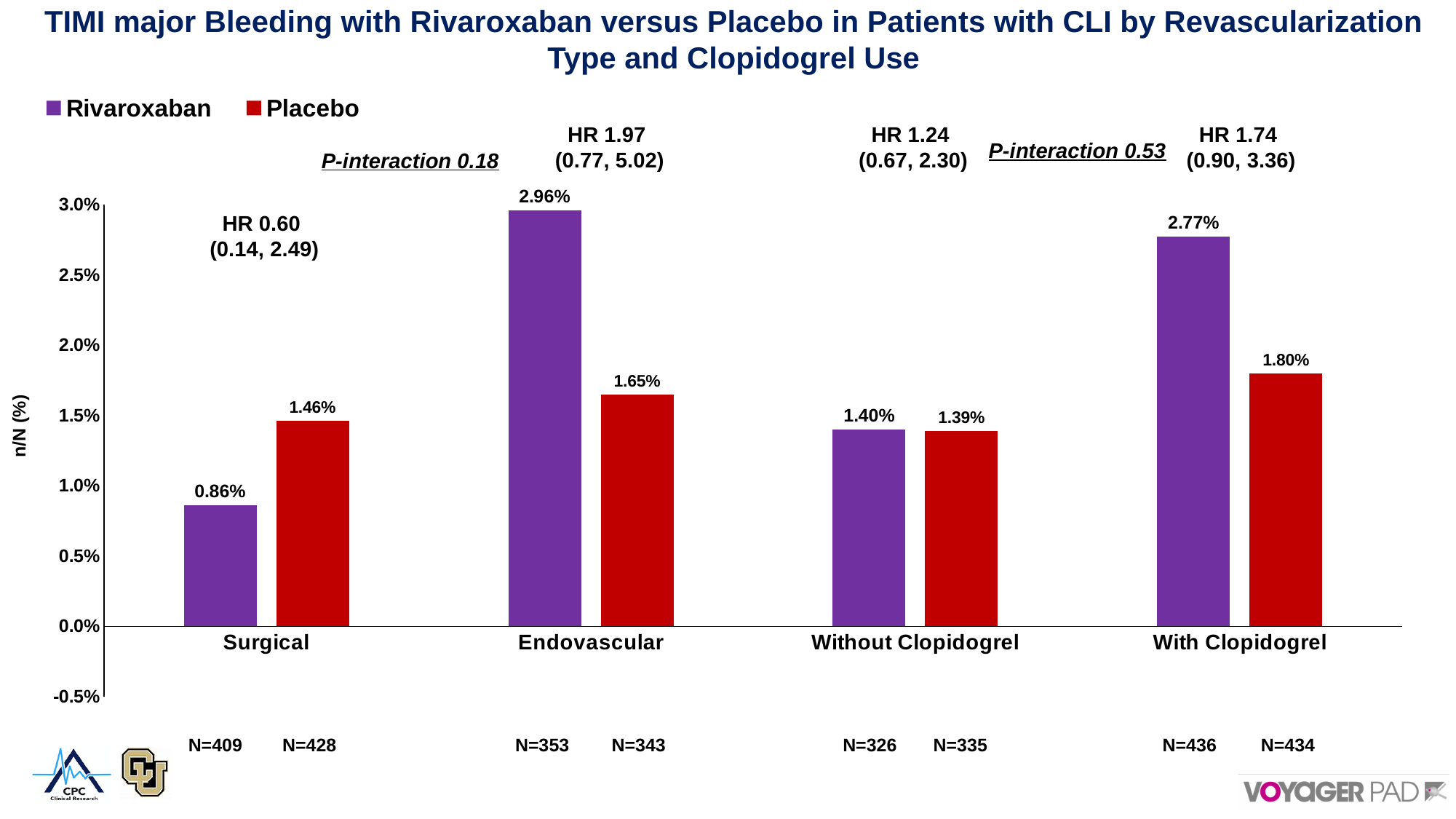
Which category has the highest Rivaroxaban bleeding rate? Endovascular How many series does the legend list? 2 What is the difference between the Rivaroxaban and Placebo bleeding rates in the Endovascular group? 1.31% What is the hazard ratio shown for the Endovascular group? HR 1.97 What kind of chart is shown on the slide? Bar chart Is the Placebo bleeding rate in the With Clopidogrel group greater or less than 1.5%? greater In the Surgical group, which is larger, the Rivaroxaban or the Placebo bleeding rate? Placebo What is the TIMI major bleeding rate for Rivaroxaban in the Surgical group? 0.86% How many categories are shown on the x axis? 4 What is the TIMI major bleeding rate for Placebo in the Endovascular group? 1.65% Which category has the lowest Rivaroxaban bleeding rate? Surgical What is the TIMI major bleeding rate for Rivaroxaban in the With Clopidogrel group? 2.77%